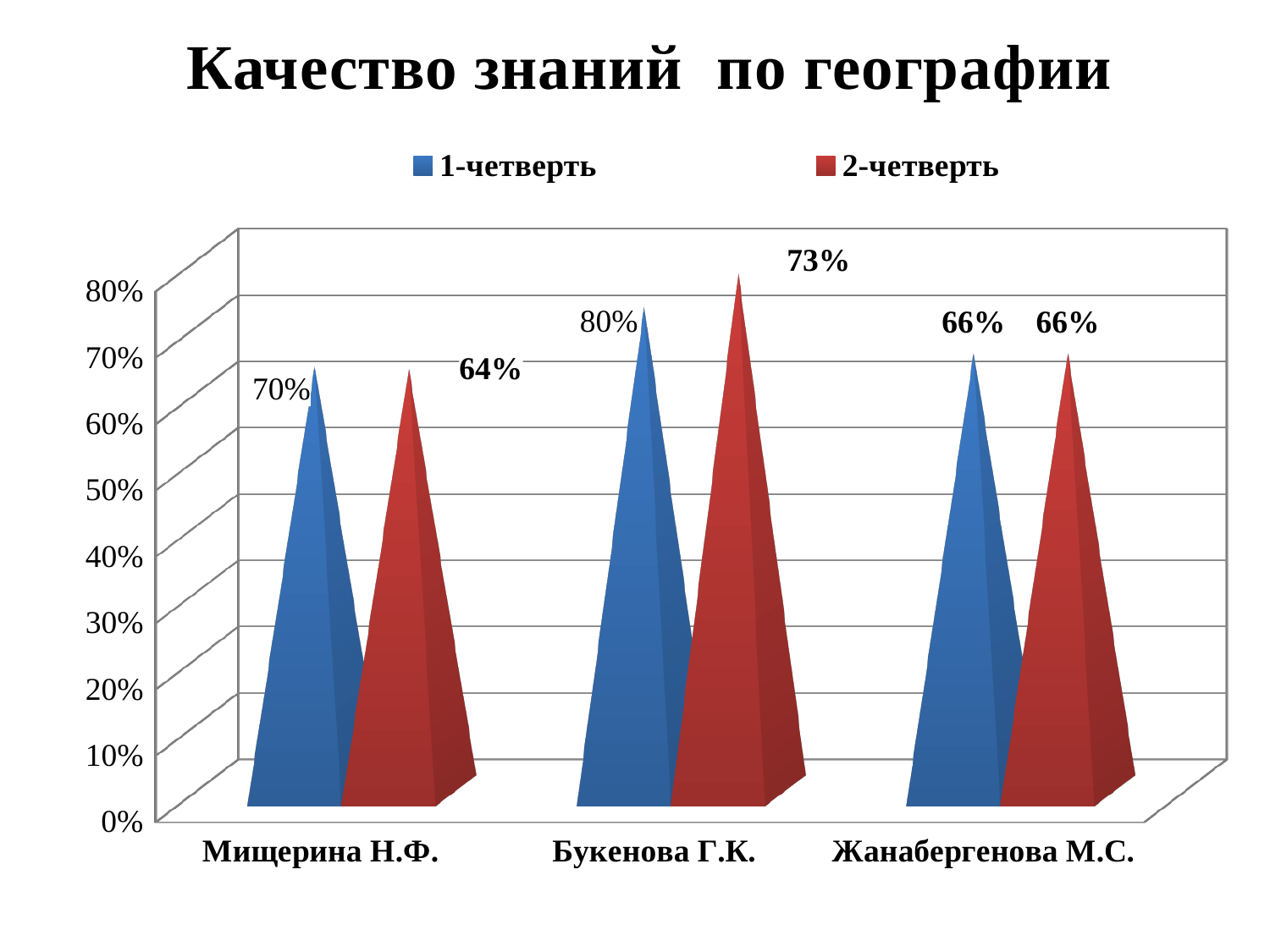
What is the difference between the 1-четверть and 2-четверть values for Букенова Г.К.? 7% What is the title of the chart? Качество знаний по географии What is the value for Жанабергенова М.С. in the 1-четверть series? 66% How many series does the legend list? 2 What is the value for Мищерина Н.Ф. in the 2-четверть series? 64% Which teacher has the lowest value in the 2-четверть series? Мищерина Н.Ф. What kind of chart is shown on the slide? Bar chart What is the value for Букенова Г.К. in the 2-четверть series? 73% Which is larger for Мищерина Н.Ф.: the 1-четверть value or the 2-четверть value? 1-четверть What is the value for Мищерина Н.Ф. in the 1-четверть series? 70% Which teacher has the highest value in the 1-четверть series? Букенова Г.К. How many teachers (categories) are shown on the x axis? 3